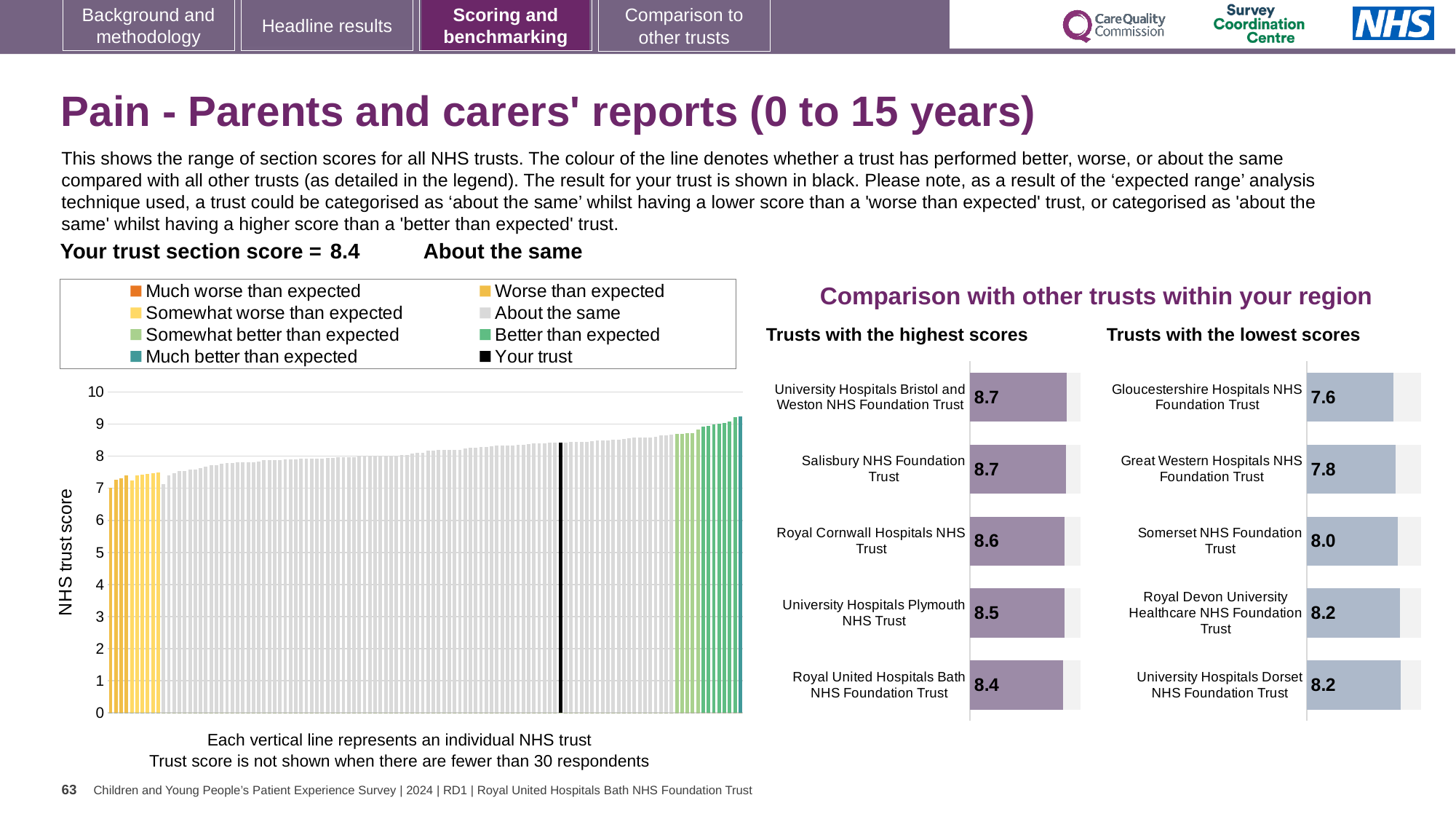
In the 'NHS trust score' chart on the left, do the bars rise or fall from left to right? Rise In the 'Trusts with the lowest scores' chart, which trust has the lowest score? Gloucestershire Hospitals NHS Foundation Trust How many entries does the legend of the NHS trust score chart list? 8 In the 'Trusts with the highest scores' chart, which trust has the lowest score shown? Royal United Hospitals Bath NHS Foundation Trust In the 'Trusts with the lowest scores' chart, what is the difference between the scores of Somerset NHS Foundation Trust and Gloucestershire Hospitals NHS Foundation Trust? 0.4 In the 'Trusts with the lowest scores' chart, what is the score for Great Western Hospitals NHS Foundation Trust? 7.8 In the 'Trusts with the highest scores' chart, what is the difference between the scores of Salisbury NHS Foundation Trust and University Hospitals Plymouth NHS Trust? 0.2 In the 'NHS trust score' chart on the left, what colour is used for 'Your trust' according to the legend? Black In the 'Trusts with the highest scores' chart, what is the score for Royal Cornwall Hospitals NHS Trust? 8.6 What kind of chart is the 'NHS trust score' chart on the left? Bar chart How many trusts are listed in the 'Trusts with the highest scores' chart? 5 In the 'Trusts with the lowest scores' chart, which has the higher score: Somerset NHS Foundation Trust or Great Western Hospitals NHS Foundation Trust? Somerset NHS Foundation Trust